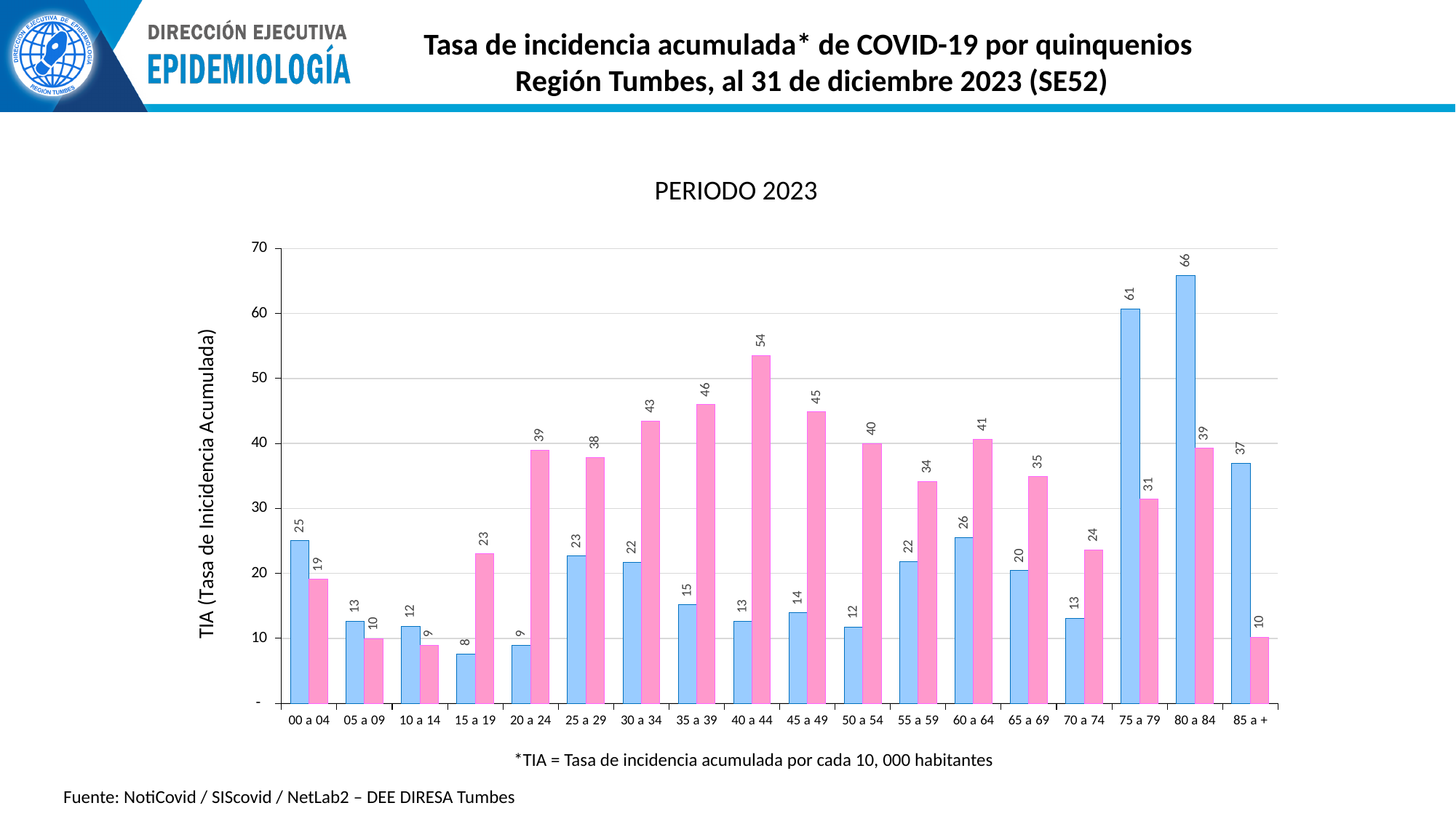
What is the value of the blue bar for the 40 a 44 age group? 13 What kind of chart is shown on the slide? bar chart Which age group has the highest blue bar? 80 a 84 For the 20 a 24 age group, which bar is larger, the blue or the pink? pink What is the value of the pink bar for the 40 a 44 age group? 54 What is the title shown above the chart? PERIODO 2023 Which age group has the highest pink bar? 40 a 44 Which age group has the lowest blue bar? 15 a 19 Is the value of the pink bar for the 35 a 39 age group greater or less than 40? greater What is the difference between the blue and pink bars for the 75 a 79 age group? 30 How many age groups are shown on the x axis? 18 What is the value of the blue bar for the 80 a 84 age group? 66